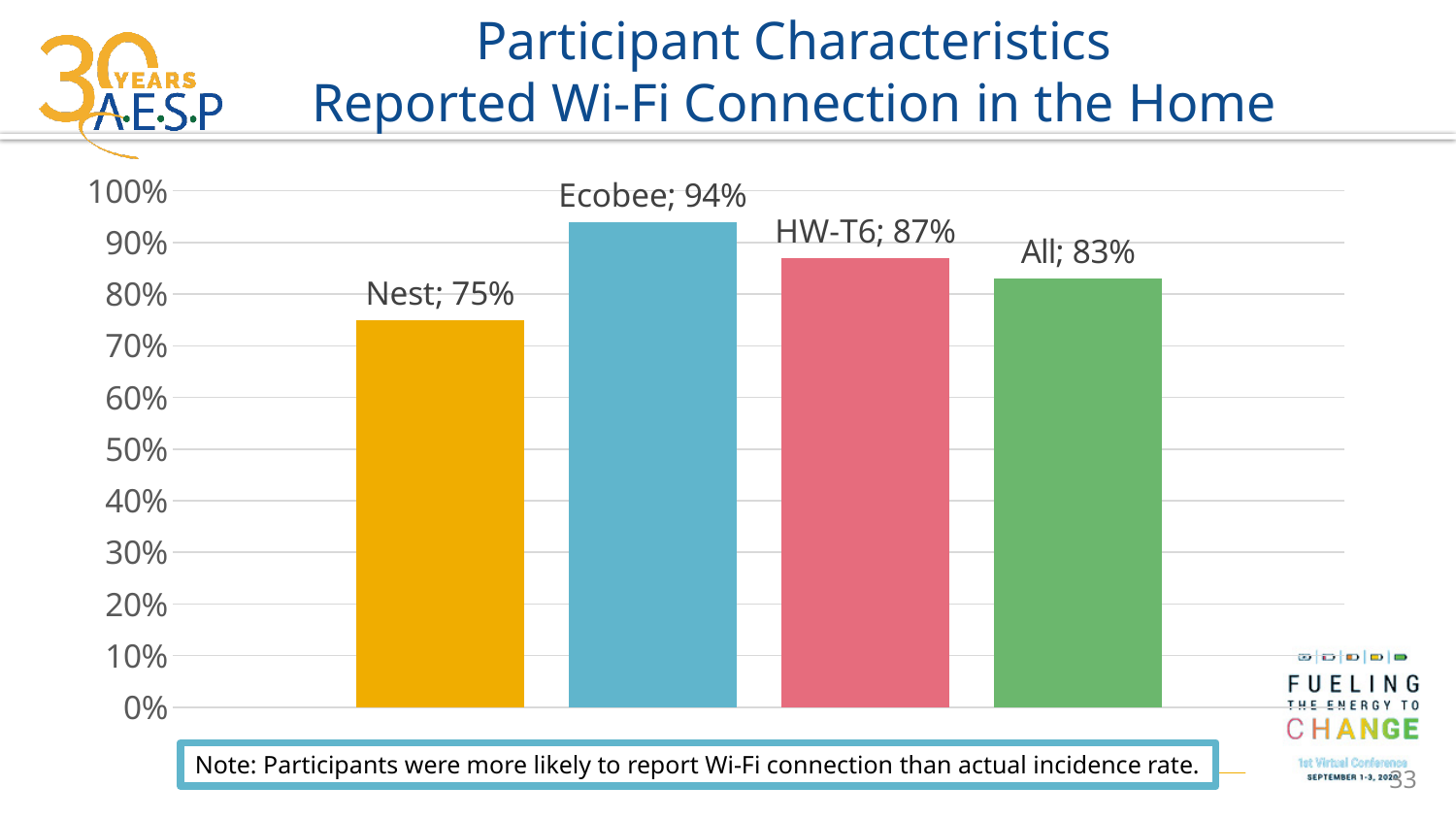
Which is larger, the value for HW-T6 or the value for All? HW-T6 What is the value shown for Ecobee? 94% What is the value shown for the All category? 83% What kind of chart is shown on the slide? Bar chart Which category has the lowest reported Wi-Fi connection rate? Nest What colour is the bar for Ecobee? Blue What is the value shown for HW-T6? 87% What is the difference between the Ecobee and Nest values? 19% What is the difference between the HW-T6 and All values? 4% How many categories are shown in the chart? 4 What percentage of Nest participants reported a Wi-Fi connection in the home? 75% Which category has the highest reported Wi-Fi connection rate? Ecobee